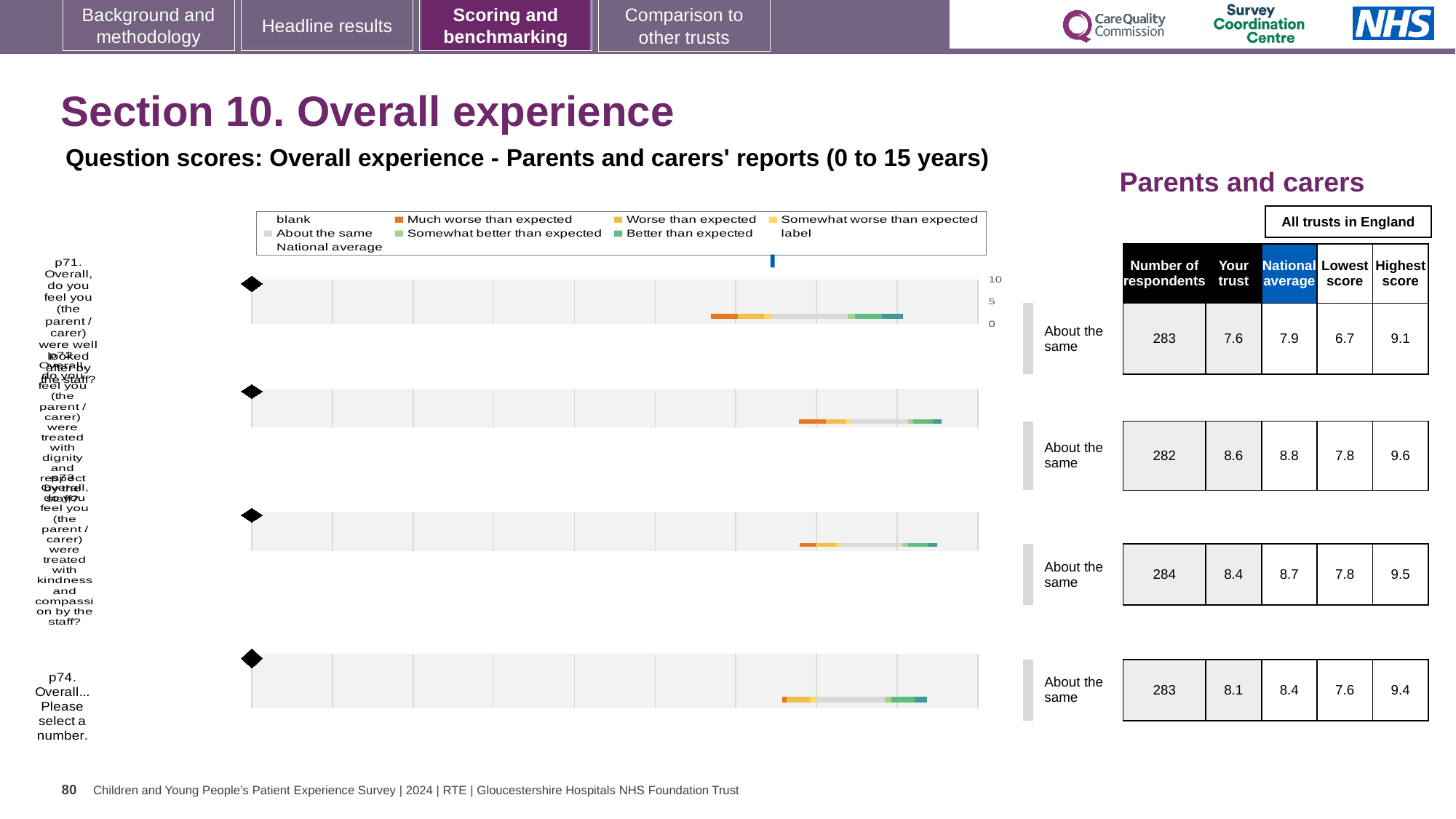
For p73, which is larger: the 'Your trust' score or the National average? National average In the table beside the chart, how many respondents are listed for the third question (p73)? 284 Which question has the highest 'Your trust' score in the table beside the chart? p72 What is the title of the chart? Question scores: Overall experience - Parents and carers' reports (0 to 15 years) What kind of chart is shown on the slide? bar chart What benchmark category is shown for all four questions in the chart? About the same Which question has the lowest 'Your trust' score in the table beside the chart? p71 In the table beside the chart, what is the 'Your trust' score for p74 (Overall... Please select a number)? 8.1 For p72, what is the difference between the National average and the 'Your trust' score? 0.2 How many questions (rows) are plotted in the chart? 4 Which legend entry is shown in orange? Much worse than expected In the table beside the chart, what is the National average for the second question (p72)? 8.8